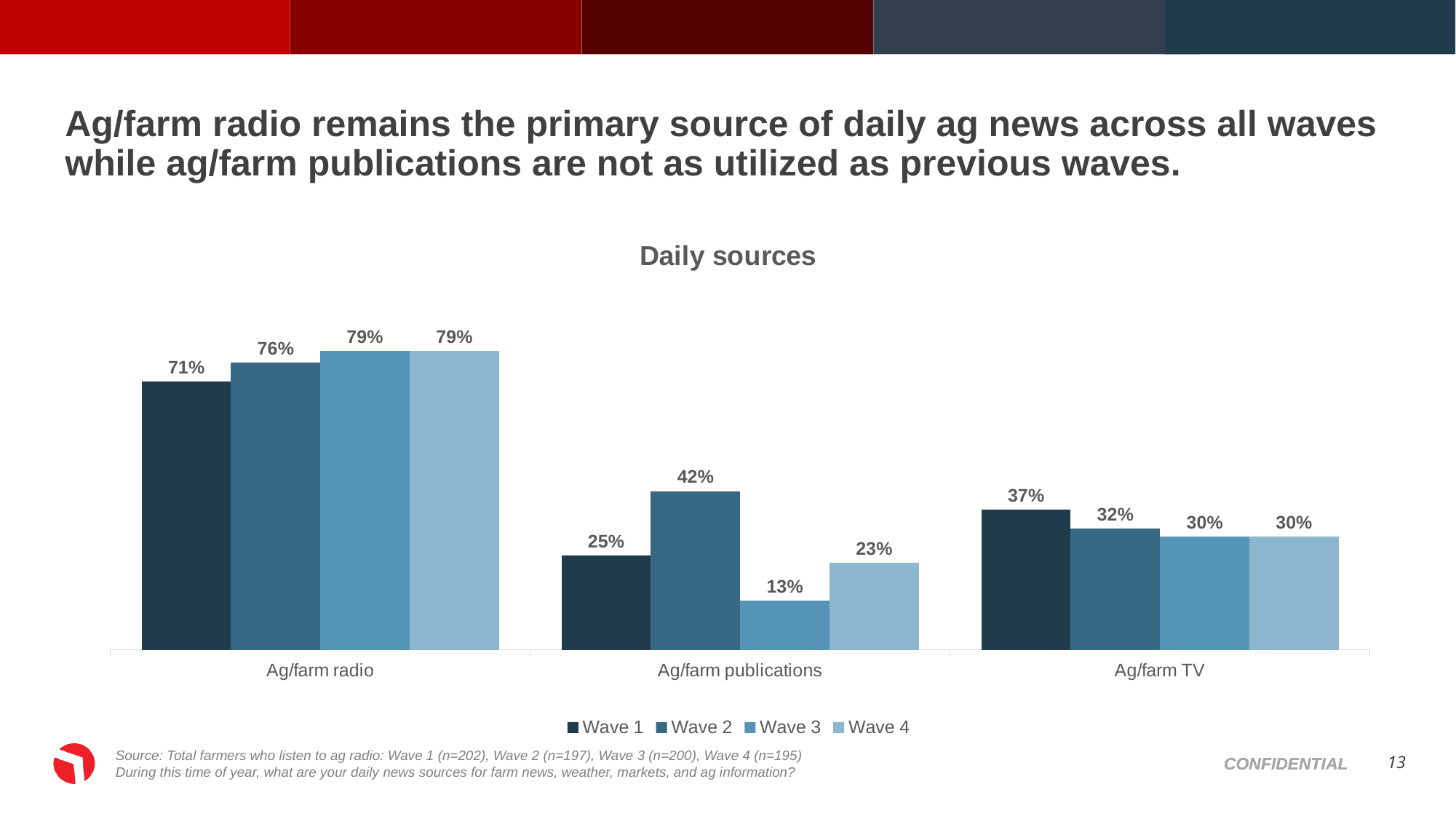
Which is larger: the Wave 1 value for Ag/farm TV or the Wave 1 value for Ag/farm publications? Ag/farm TV What is the difference between the Wave 1 and Wave 4 values for Ag/farm radio? 8% What is the Wave 3 value for Ag/farm publications? 13% What kind of chart is shown? Bar chart What is the Wave 4 value for Ag/farm TV? 30% Which wave has the lowest value for Ag/farm publications? Wave 3 What is the Wave 1 value for Ag/farm radio? 71% How many series does the legend list? 4 What is the title of the chart? Daily sources What is the difference between the Wave 2 and Wave 3 values for Ag/farm publications? 29% Which category has the highest Wave 2 value? Ag/farm radio How many categories are shown on the x axis? 3